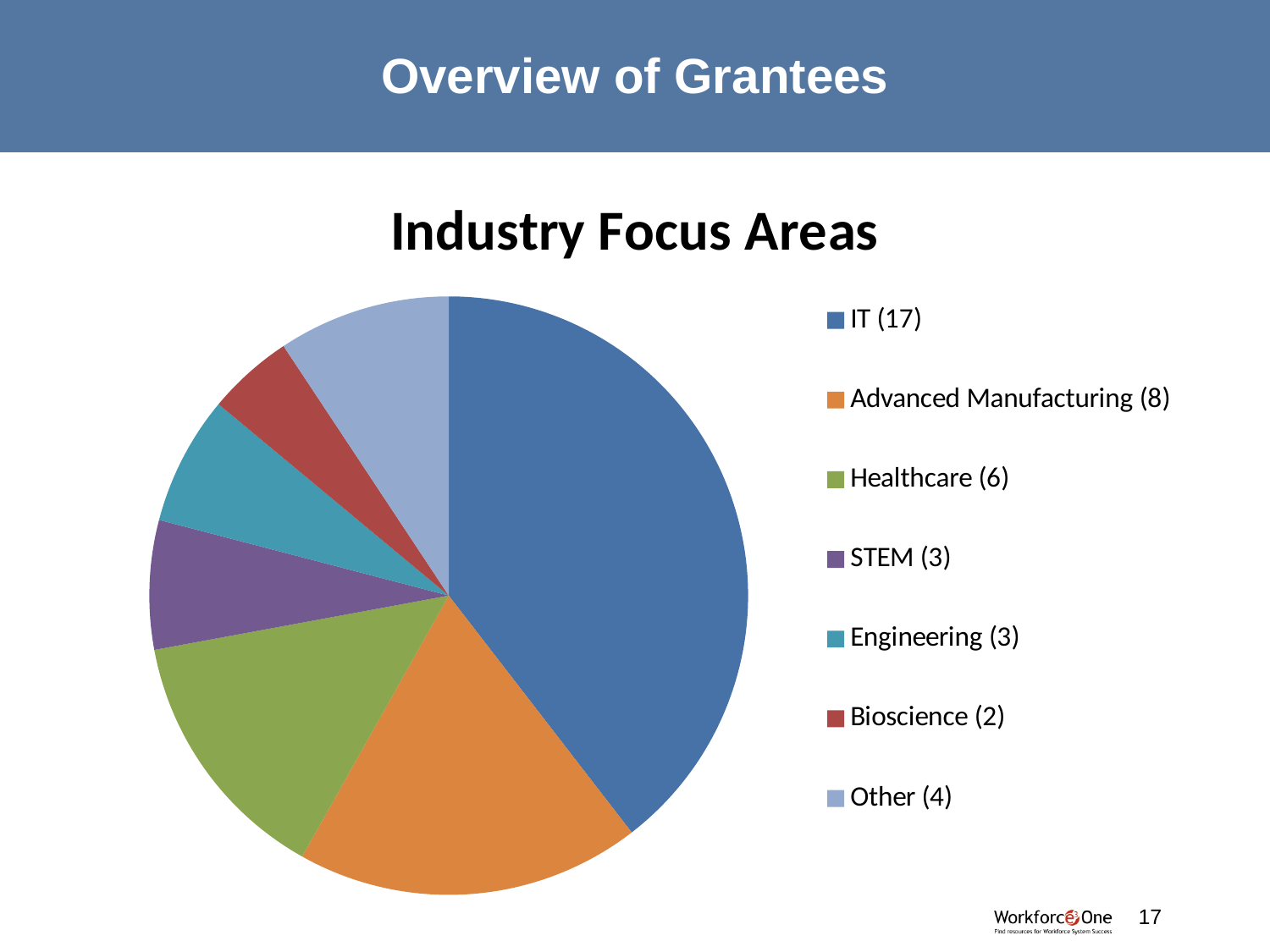
How many categories does the pie chart have? 7 What is the value for IT? 17 Which category has the largest slice? IT Which is larger, Healthcare or Other? Healthcare What is the value for Bioscience? 2 What is the value for Healthcare? 6 What is the value for Advanced Manufacturing? 8 Which category has the smallest slice? Bioscience What is the title of the chart? Industry Focus Areas What is the total of all the values shown in the legend? 43 What type of chart is shown on the slide? Pie chart What is the difference between the values for IT and Advanced Manufacturing? 9